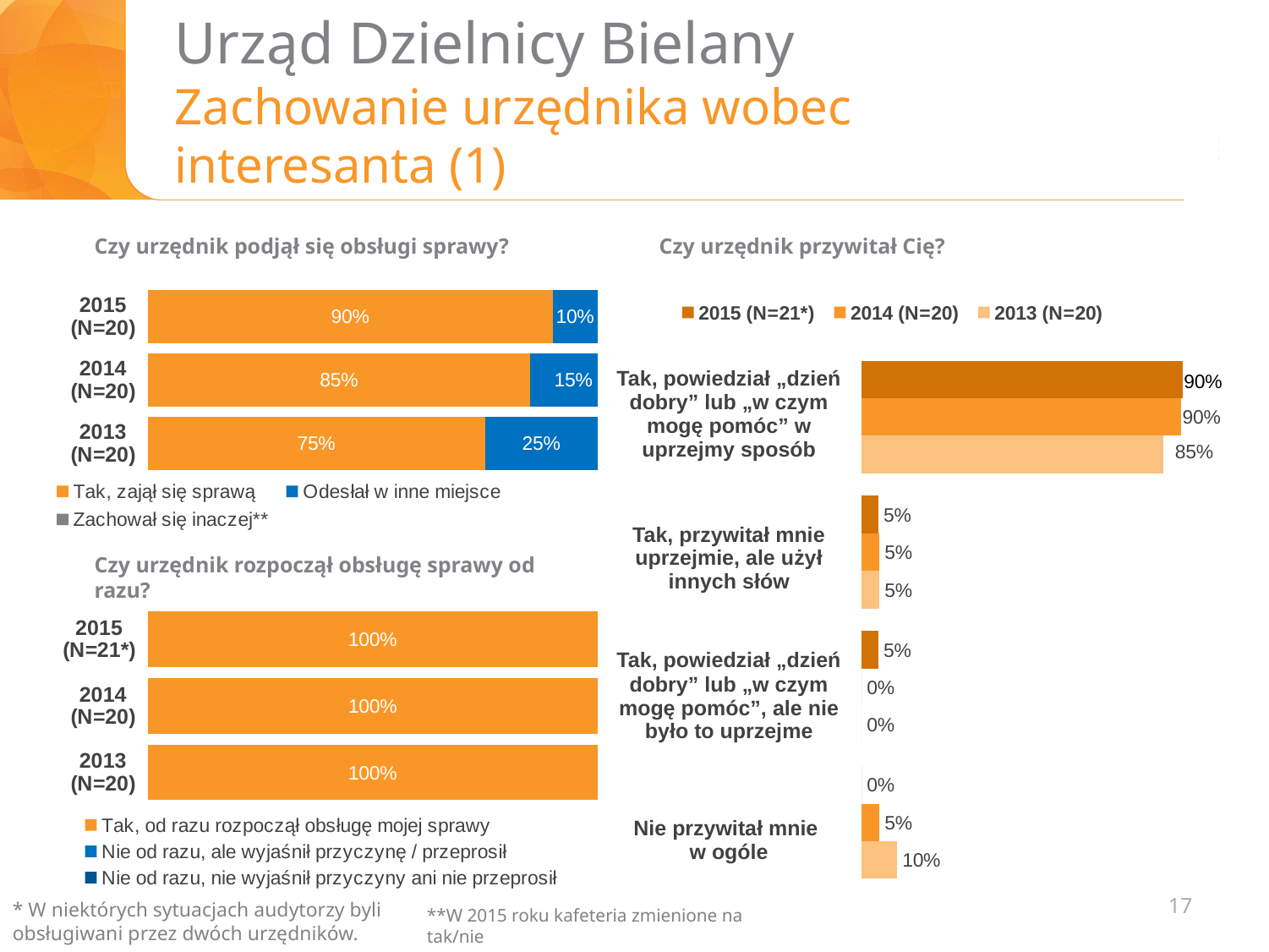
In the chart "Czy urzędnik podjął się obsługi sprawy?", how does the "Tak, zajął się sprawą" share change from 2013 to 2015? It rises In the chart "Czy urzędnik rozpoczął obsługę sprawy od razu?", how many year categories are shown? 3 In the chart "Czy urzędnik podjął się obsługi sprawy?", what percentage for 2013 (N=20) is "Odesłał w inne miejsce"? 25% In the chart "Czy urzędnik podjął się obsługi sprawy?", which year has the lowest share of "Tak, zajął się sprawą"? 2013 (N=20) In the chart "Czy urzędnik przywitał Cię?", what is the 2013 (N=20) value for "Tak, powiedział „dzień dobry” lub „w czym mogę pomóc” w uprzejmy sposób"? 85% In the chart "Czy urzędnik podjął się obsługi sprawy?", how many legend entries are listed? 3 What type of chart is "Czy urzędnik przywitał Cię?"? Bar chart In the chart "Czy urzędnik rozpoczął obsługę sprawy od razu?", what percentage for 2014 (N=20) is "Tak, od razu rozpoczął obsługę mojej sprawy"? 100% In the chart "Czy urzędnik przywitał Cię?", what is the 2013 (N=20) value for "Nie przywitał mnie w ogóle"? 10% In the chart "Czy urzędnik podjął się obsługi sprawy?", what is the difference between the "Odesłał w inne miejsce" share in 2013 and in 2015? 15 percentage points In the chart "Czy urzędnik przywitał Cię?", which is larger for 2015 (N=21*): "Tak, przywitał mnie uprzejmie, ale użył innych słów" or "Nie przywitał mnie w ogóle"? Tak, przywitał mnie uprzejmie, ale użył innych słów In the chart "Czy urzędnik podjął się obsługi sprawy?", what percentage for 2015 (N=20) is "Tak, zajął się sprawą"? 90%